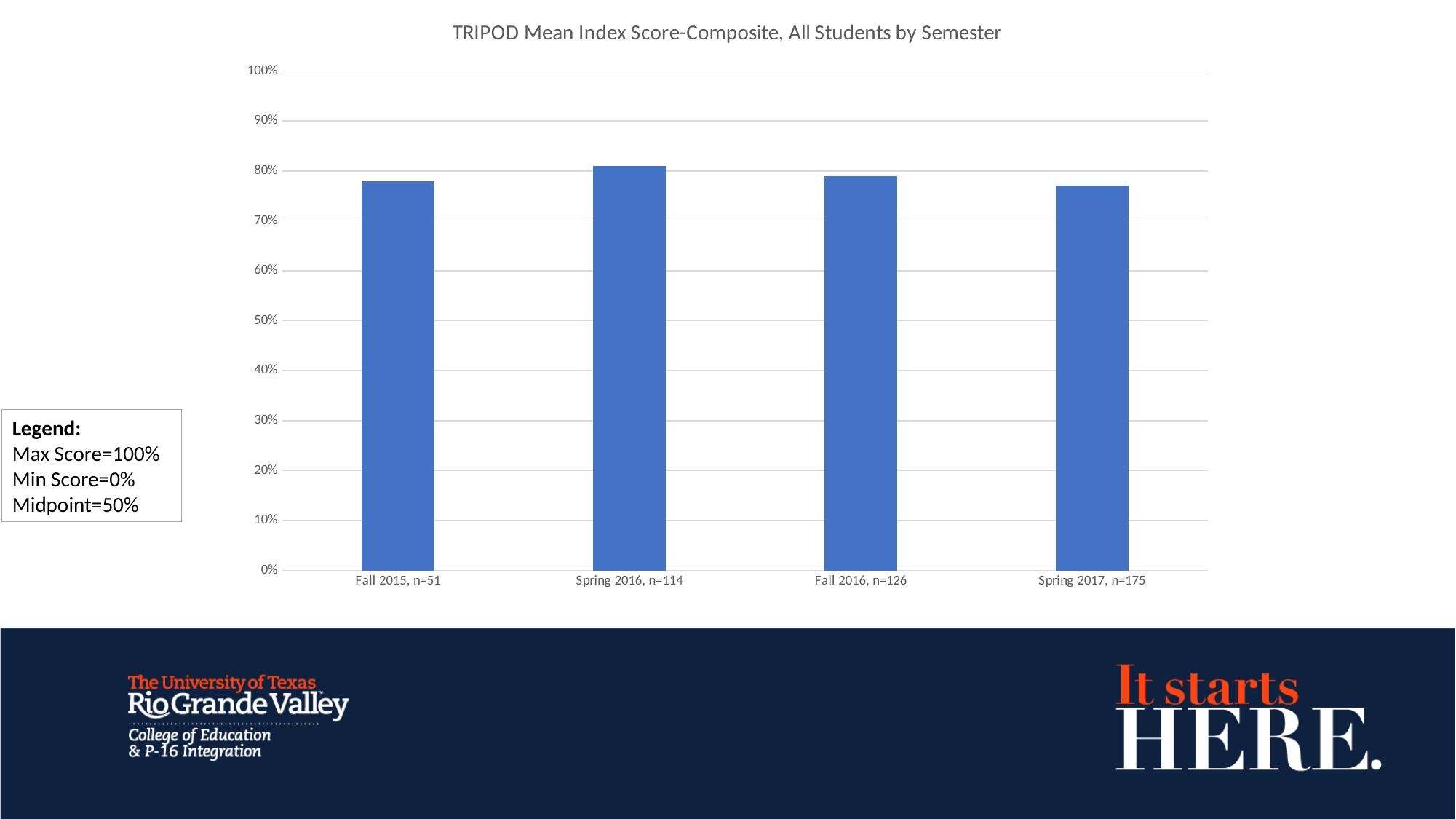
What is the sample size (n) shown for Fall 2016? 126 Which is larger, the value for Spring 2016, n=114 or the value for Spring 2017, n=175? Spring 2016, n=114 Which semester has the highest mean index score? Spring 2016, n=114 What kind of chart is shown on the slide? bar chart How many semesters (bars) are shown in the chart? 4 Is the value for Fall 2015, n=51 greater or less than 80%? less Is the value for Fall 2016, n=126 greater or less than 50%? greater Is the value for Fall 2015, n=51 greater or less than 70%? greater What is the title of the chart? TRIPOD Mean Index Score-Composite, All Students by Semester Which is larger, the value for Fall 2015, n=51 or the value for Spring 2016, n=114? Spring 2016, n=114